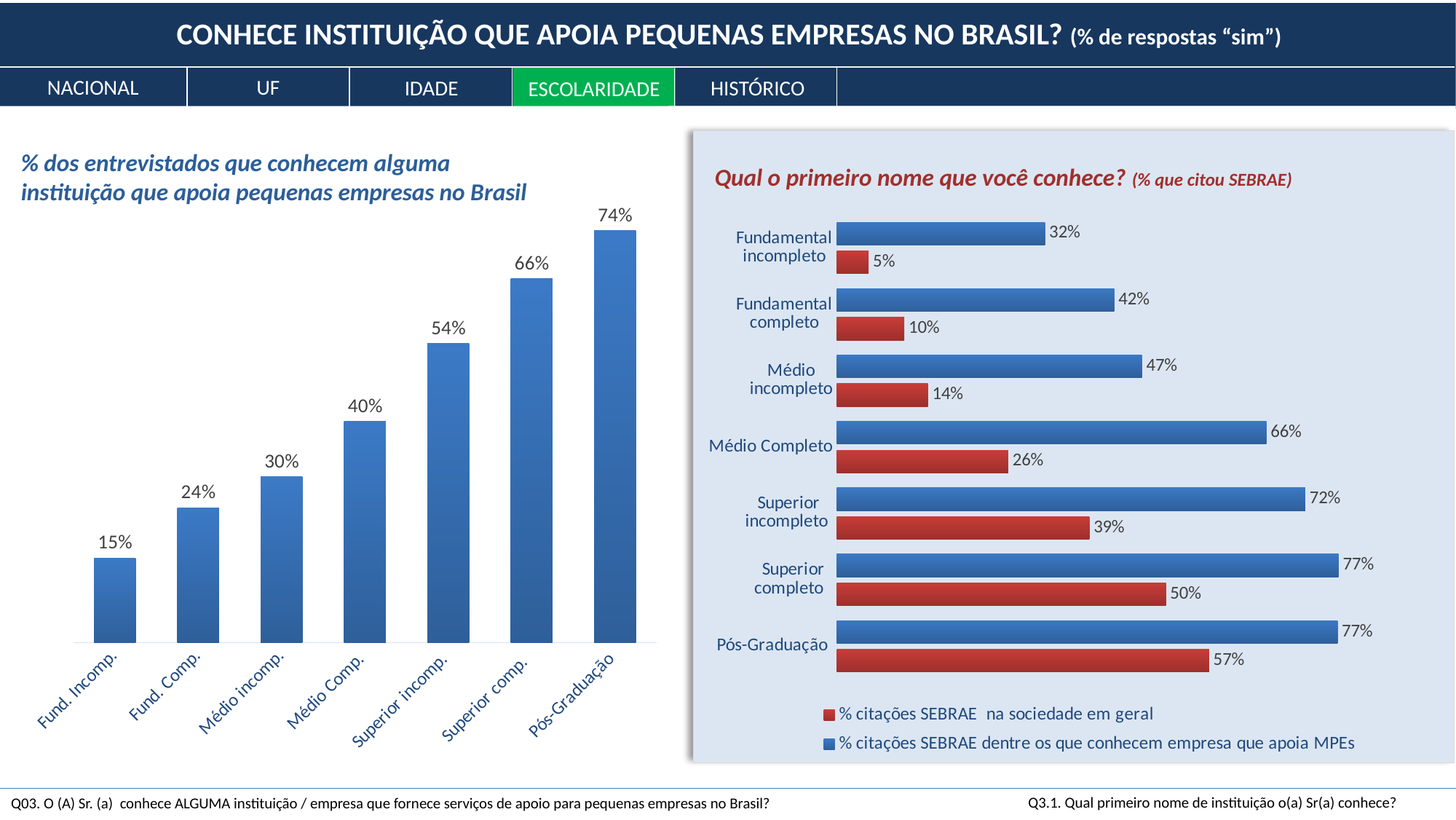
In the left chart (% dos entrevistados que conhecem alguma instituição), which category has the lowest value? Fund. Incomp. In the left chart (% dos entrevistados que conhecem alguma instituição), how many categories are shown? 7 What kind of chart is the right chart (Qual o primeiro nome que você conhece?)? bar chart In the right chart (Qual o primeiro nome que você conhece?), which is larger for Superior incompleto: the blue series or the red series? the blue series (72%) In the left chart (% dos entrevistados que conhecem alguma instituição), what is the difference between Superior comp. and Superior incomp.? 12% In the right chart (Qual o primeiro nome que você conhece?), what is the difference between the two series for Pós-Graduação? 20% In the right chart (Qual o primeiro nome que você conhece?), what is the value of '% citações SEBRAE na sociedade em geral' for Médio Completo? 26% In the right chart (Qual o primeiro nome que você conhece?), what is the value of '% citações SEBRAE dentre os que conhecem empresa que apoia MPEs' for Fundamental completo? 42% In the left chart (% dos entrevistados que conhecem alguma instituição), what is the value for Médio Comp.? 40% In the left chart (% dos entrevistados que conhecem alguma instituição), which category has the highest value? Pós-Graduação In the right chart (Qual o primeiro nome que você conhece?), how many series does the legend list? 2 In the left chart (% dos entrevistados que conhecem alguma instituição), do the values rise or fall from Fund. Incomp. to Pós-Graduação? rise